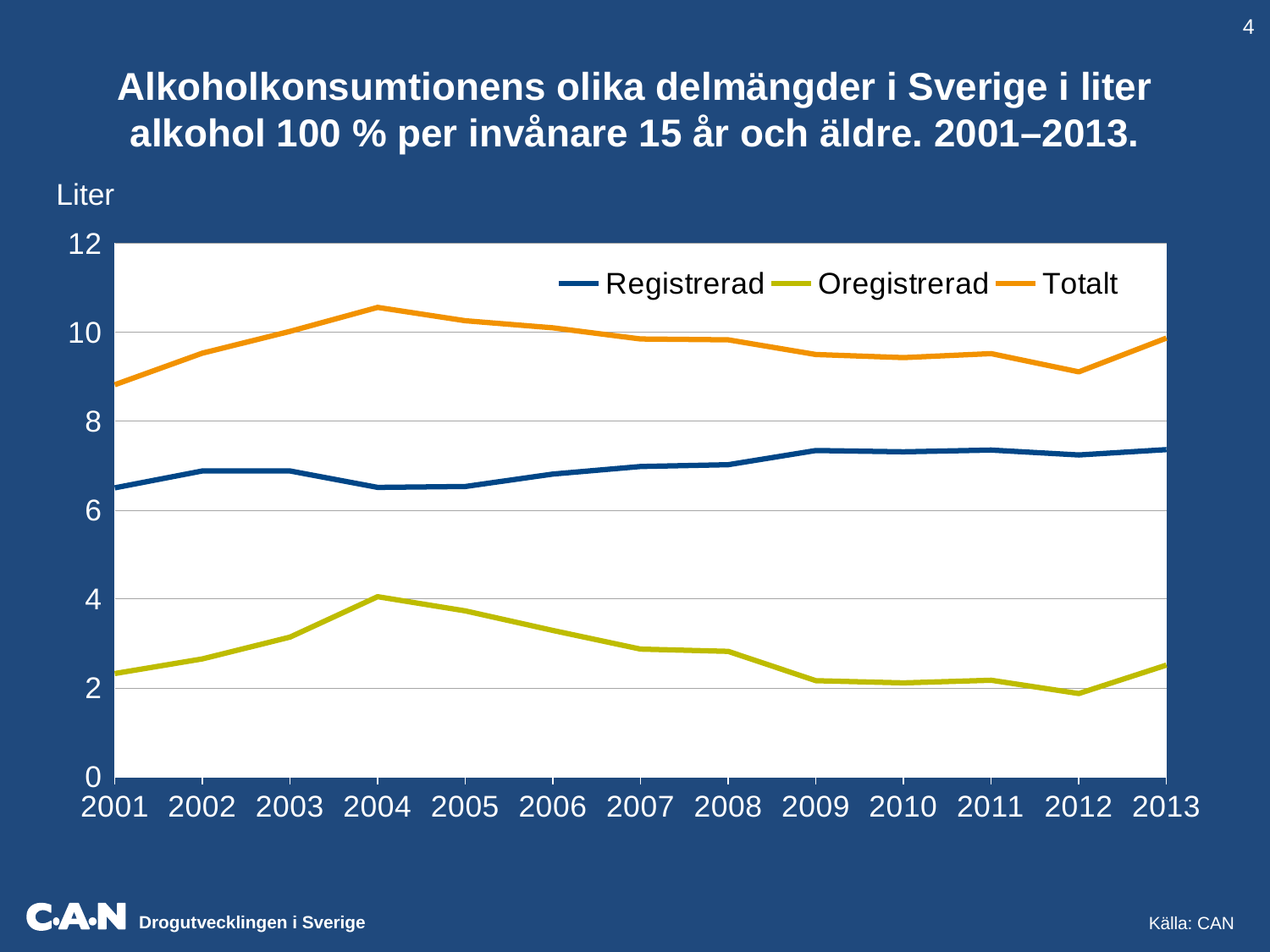
In which year does the Totalt series reach its highest value? 2004 What is the label on the y axis of the chart? Liter What kind of chart is shown on the slide? Line chart How many series does the legend list? 3 How many years are shown on the x axis? 13 Is the value for Totalt in 2004 greater or less than 10? greater In which year does the Oregistrerad series reach its highest value? 2004 Which is larger, the Oregistrerad value in 2001 or in 2004? 2004 Is the value for Registrerad in 2009 greater or less than 6? greater Does the Oregistrerad series rise or fall between 2004 and 2012? fall In which year does the Oregistrerad series reach its lowest value? 2012 Is the value for Totalt in 2001 greater or less than 10? less